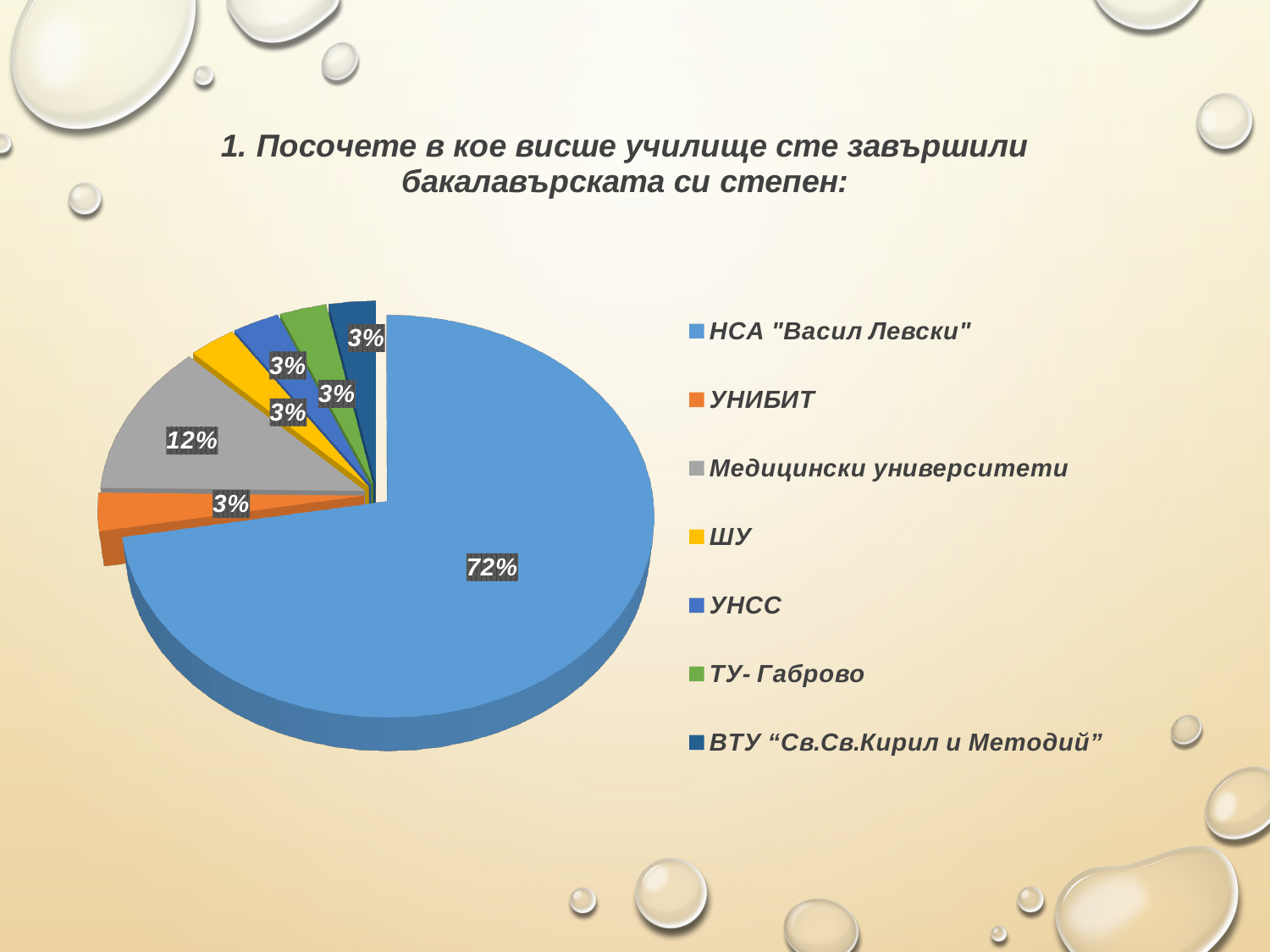
What is the value shown for ВТУ "Св.Св.Кирил и Методий"? 3% How many categories does the pie chart have? 7 Which colour is used for the УНИБИТ slice? Orange Which category has the largest slice of the pie? НСА "Васил Левски" What is the difference between the shares of Медицински университети and УНСС? 9% What is the value shown for ШУ? 3% What is the value shown for УНИБИТ? 3% What share of the pie does НСА "Васил Левски" have? 72% What share of the pie does Медицински университети have? 12% What kind of chart is shown on the slide? Pie chart Which is larger, the share for Медицински университети or the share for ТУ- Габрово? Медицински университети What is the difference between the shares of НСА "Васил Левски" and Медицински университети? 60%